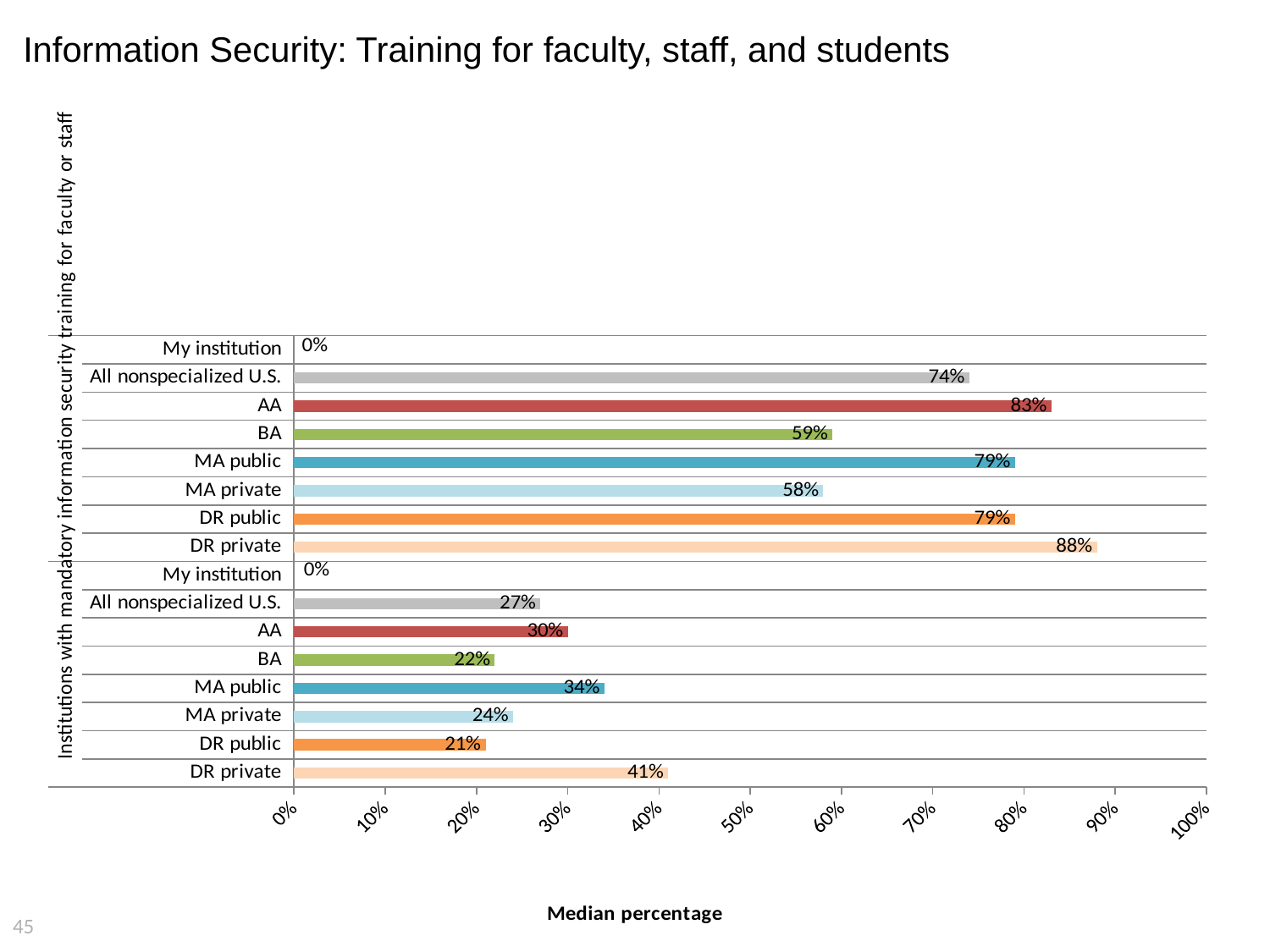
Which category has the highest value in the upper group of bars? DR private How many bars (category rows) are plotted in total on the chart? 16 What is the value for BA in the upper group of bars? 59% What is the value for MA public in the lower group of bars? 34% What kind of chart is shown on the slide? Bar chart In the upper group of bars, which is larger: the value for MA private or the value for All nonspecialized U.S.? All nonspecialized U.S. What is the label of the horizontal axis? Median percentage Excluding My institution, which category has the lowest value in the lower group of bars? DR public What is the value for All nonspecialized U.S. in the lower group of bars? 27% In the lower group of bars, which is larger: the value for DR private or the value for MA public? DR private What is the difference between the AA value in the upper group (83%) and the AA value in the lower group (30%)? 53% What is the value for DR private in the upper group of bars? 88%